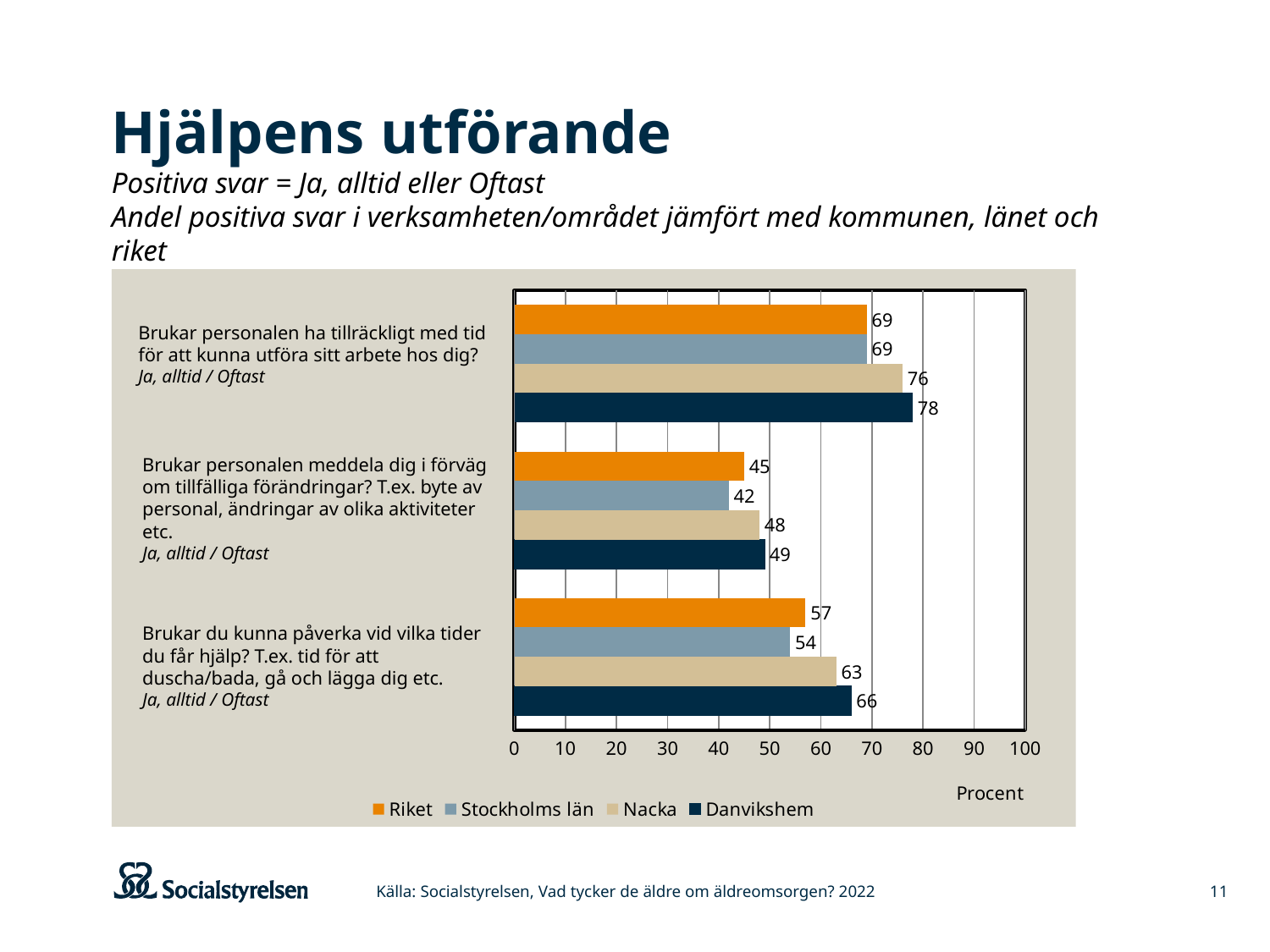
Which series has the lowest value on the question "Brukar personalen meddela dig i förväg om tillfälliga förändringar?"? Stockholms län Which series has the highest value on the question "Brukar du kunna påverka vid vilka tider du får hjälp?"? Danvikshem What type of chart is shown on the slide? bar chart What label is shown on the horizontal axis of the chart? Procent Is the value for Danvikshem on the question "Brukar personalen meddela dig i förväg om tillfälliga förändringar?" greater or less than 50? less What is the value for Stockholms län on the question "Brukar personalen meddela dig i förväg om tillfälliga förändringar?"? 42 How many question categories are shown on the chart? 3 What is the value for Nacka on the question "Brukar du kunna påverka vid vilka tider du får hjälp?"? 63 What is the value for Danvikshem on the question "Brukar personalen ha tillräckligt med tid för att kunna utföra sitt arbete hos dig?"? 78 How many series does the legend list? 4 Which is larger on the question "Brukar du kunna påverka vid vilka tider du får hjälp?": Riket or Nacka? Nacka What is the difference between Danvikshem and Riket on the question "Brukar personalen ha tillräckligt med tid för att kunna utföra sitt arbete hos dig?"? 9